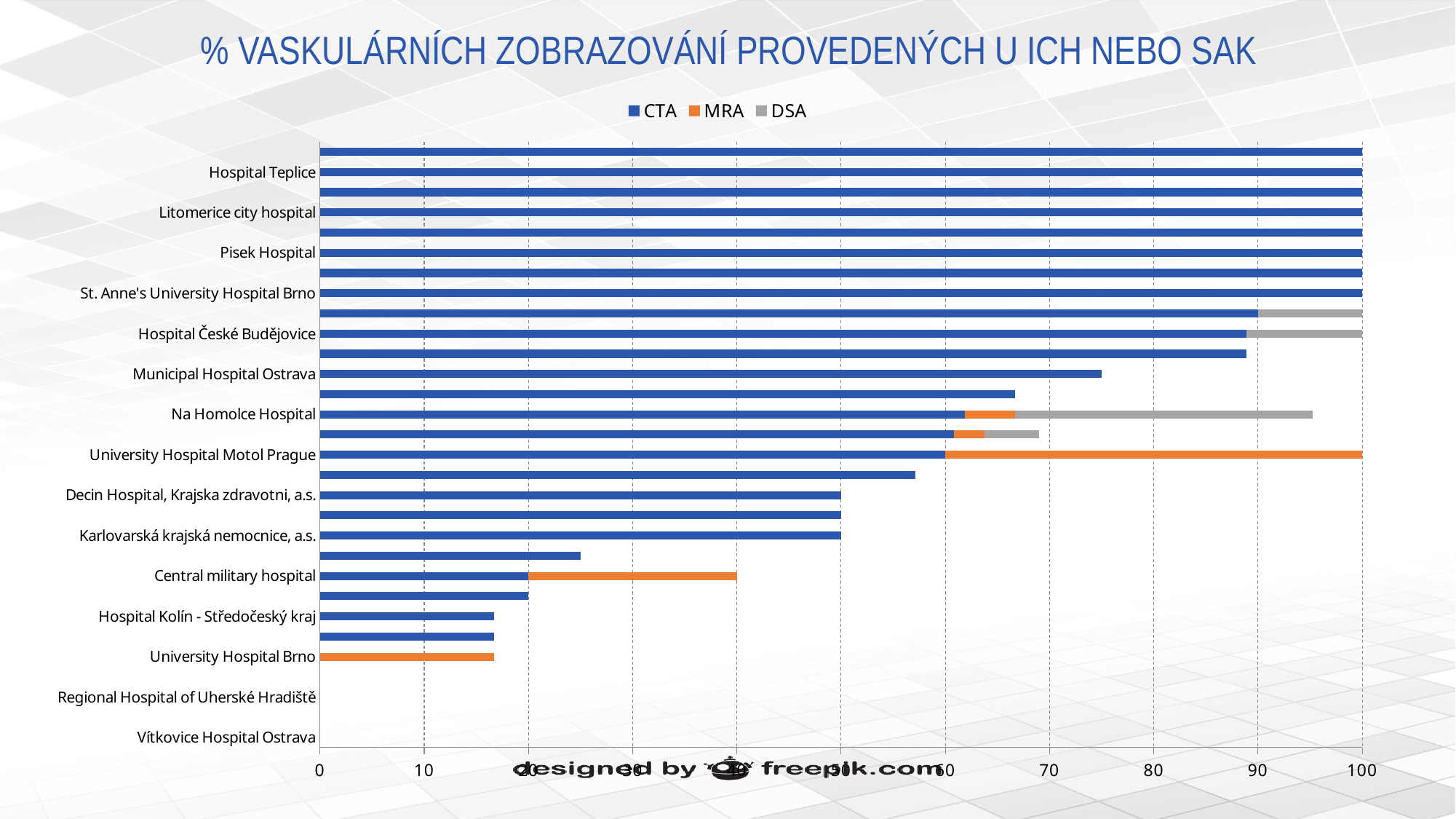
Which series are listed in the legend? CTA, MRA, DSA Is the CTA value for Municipal Hospital Ostrava greater or less than 70? greater Which series is shown in orange? MRA Which is larger, the CTA value for Pisek Hospital or the CTA value for Na Homolce Hospital? Pisek Hospital Is the CTA value for Hospital Kolín - Středočeský kraj greater or less than 20? less What is the CTA value for Hospital Teplice? 100 What is the CTA value for Central military hospital? 20 What is the CTA value for Decin Hospital, Krajska zdravotni, a.s.? 50 How many series does the legend list? 3 What is the total of the stacked bar for Central military hospital? 40 What is the total of the stacked bar for University Hospital Motol Prague? 100 What kind of chart is shown on the slide? bar chart